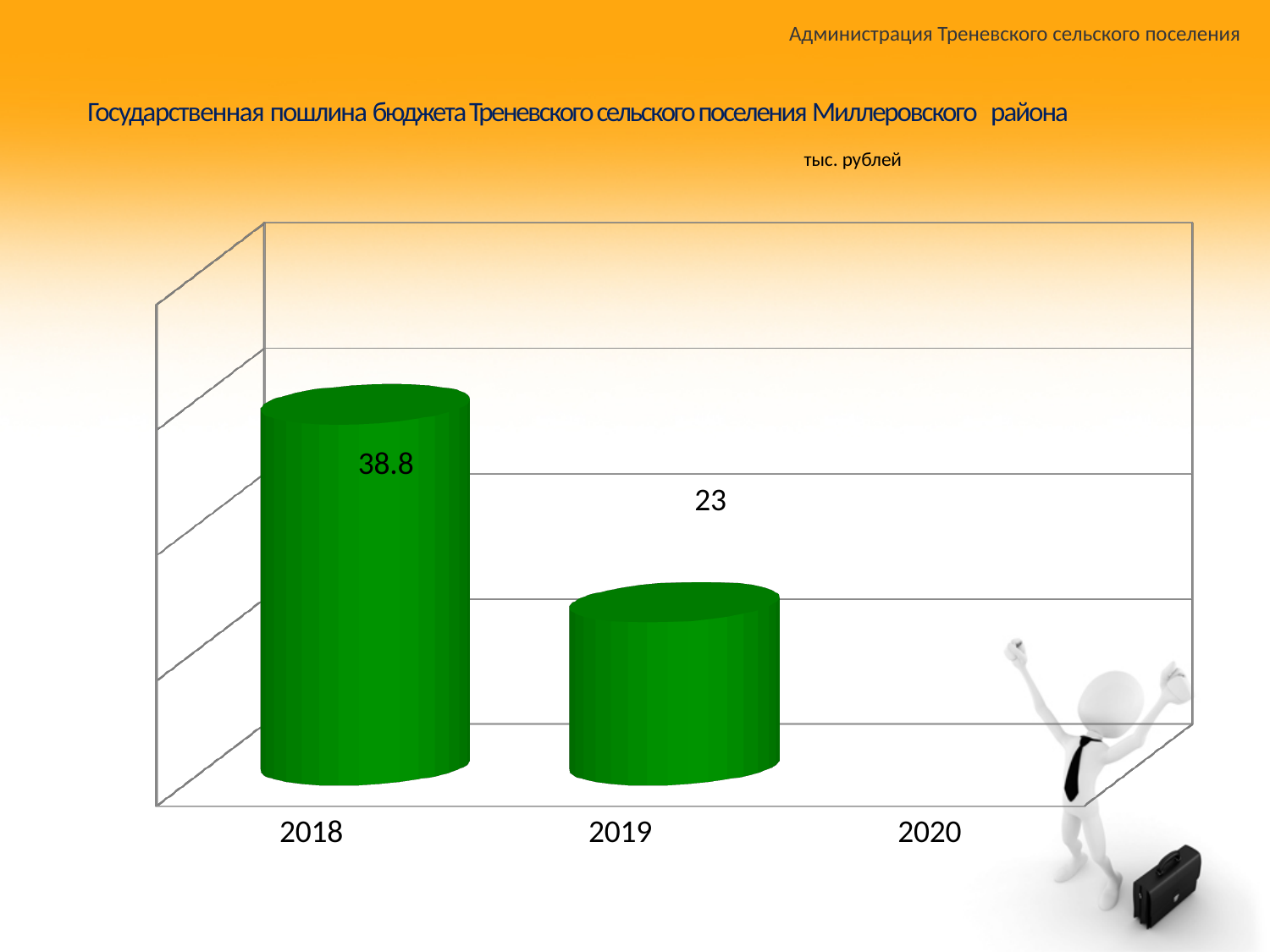
What kind of chart is shown on the slide? bar chart What is the difference between the values for 2018 and 2019? 15.8 What is the value for 2018? 38.8 How many years are labelled on the x axis? 3 In what units are the chart values given? тыс. рублей Which year on the x axis has no bar plotted? 2020 Do the values rise or fall from 2018 to 2019? fall Which year has the highest value? 2018 What is the value for 2019? 23 Which is larger, the value for 2018 or the value for 2019? 2018